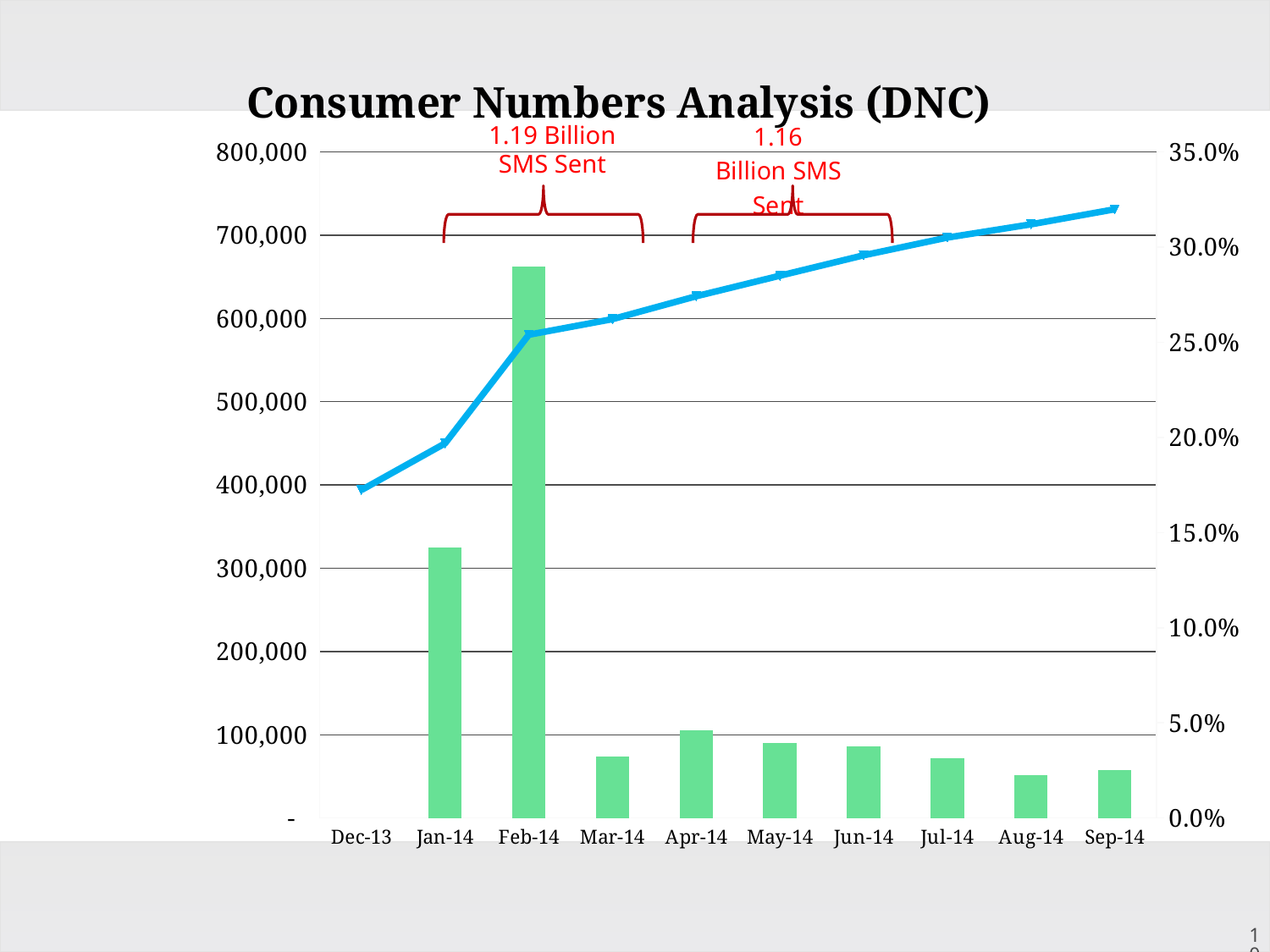
What annotation is shown above the bracket spanning Jan-14 to Mar-14? 1.19 Billion SMS Sent Does the blue line rise or fall from Dec-13 to Sep-14? It rises What is the title of the chart? Consumer Numbers Analysis (DNC) What kind of chart is shown on the slide? A combined bar and line chart How many months are shown on the x axis? 10 Which month has the tallest green bar? Feb-14 Which has the taller green bar, Mar-14 or Apr-14? Apr-14